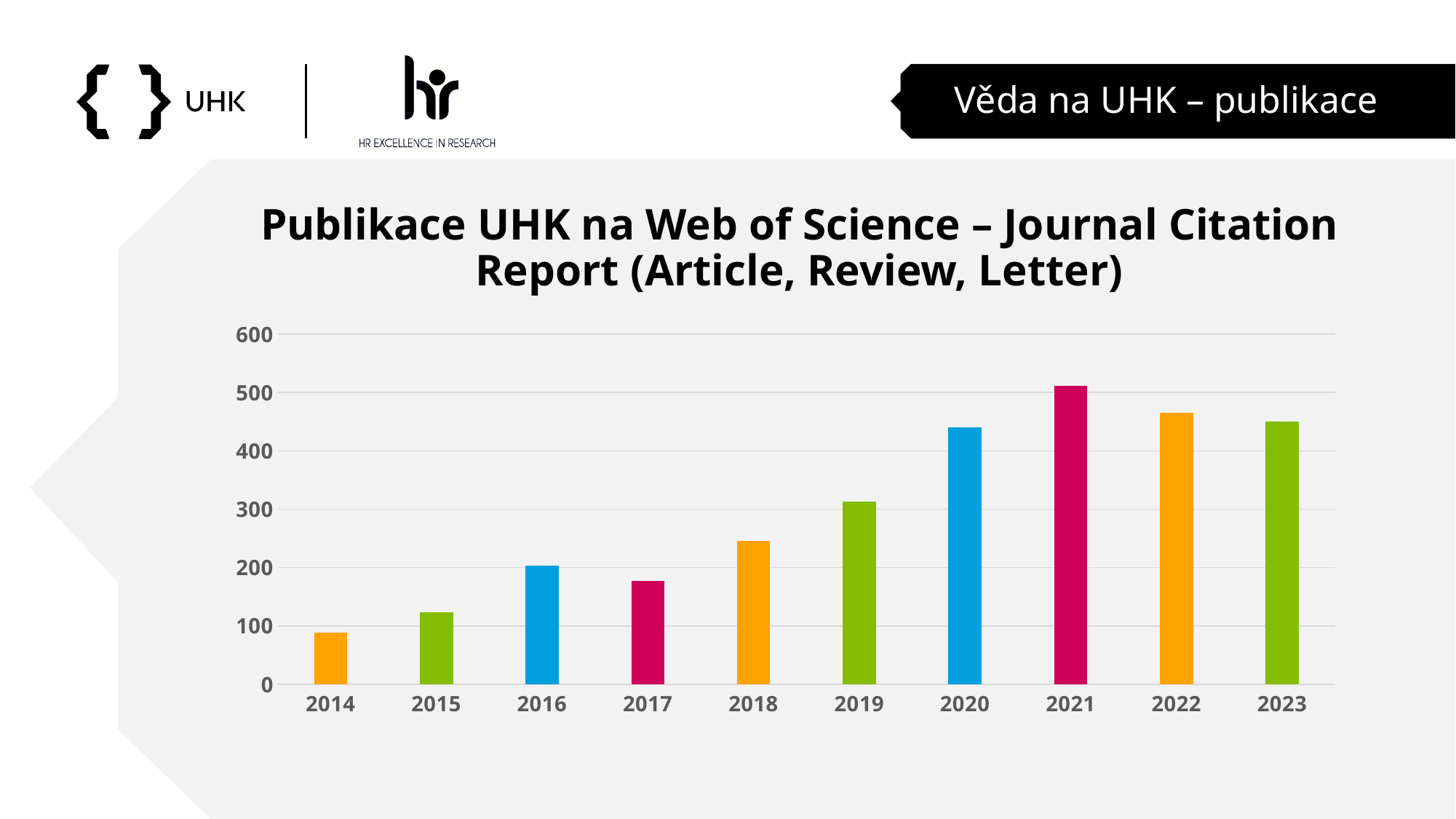
What kind of chart is shown on the slide? bar chart Do the values generally rise or fall from 2014 to 2021? rise Is the value for 2018 greater or less than 300? less Is the value for 2020 greater or less than 400? greater Is the value for 2021 greater or less than 500? greater Which year has the lowest number of publications? 2014 Which year has the highest number of publications? 2021 Which year has the larger value, 2016 or 2017? 2016 How many years are shown on the x axis of the chart? 10 What is the title of the chart? Publikace UHK na Web of Science – Journal Citation Report (Article, Review, Letter)